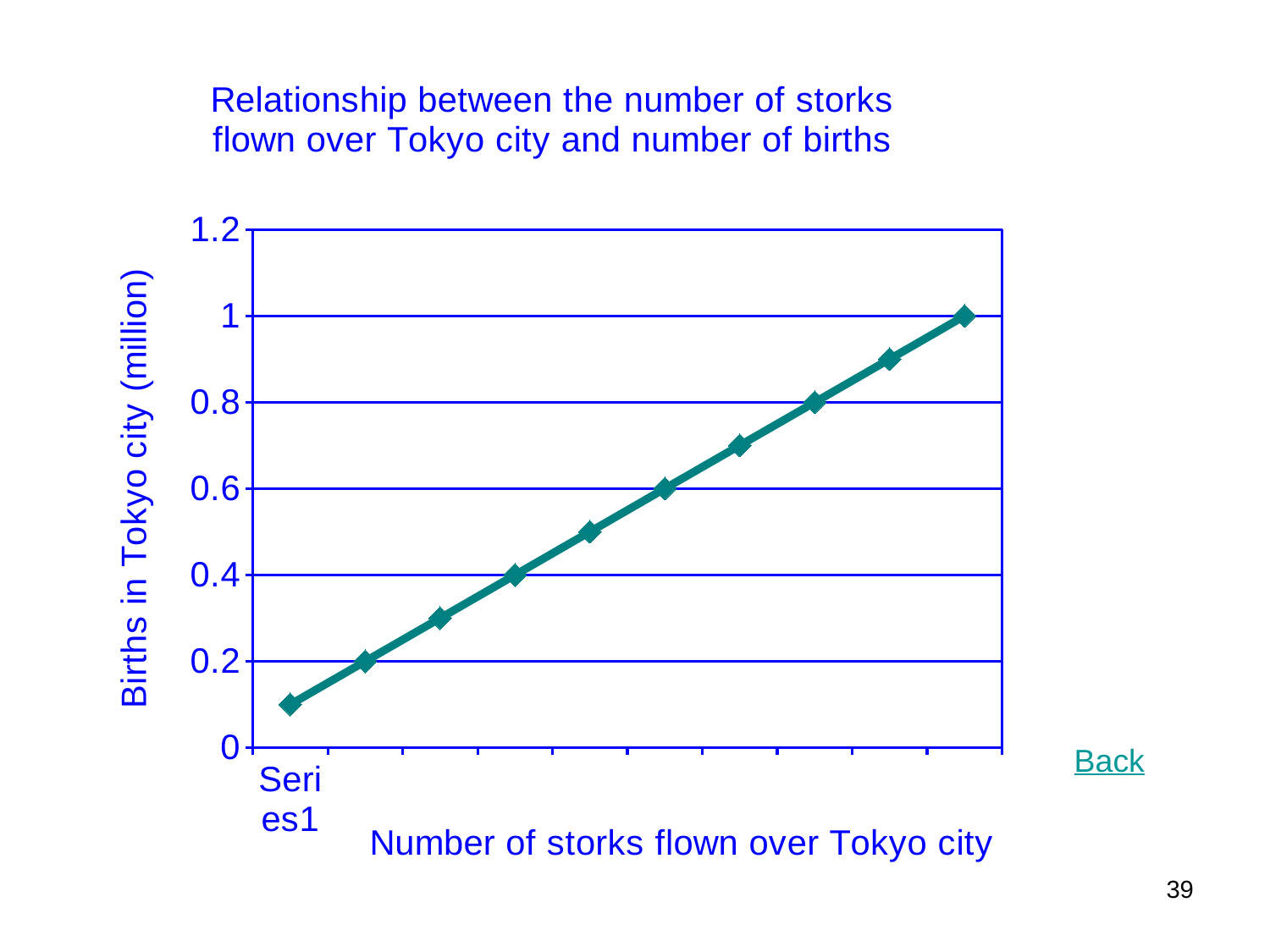
What kind of chart is shown on the slide? line chart What is the difference between the value of the last data point and the value of the second data point? 0.8 Which data point has the highest value, the leftmost or the rightmost? the rightmost What is the value of the sixth data point from the left? 0.6 Is the value of the ninth data point from the left greater or less than 0.8? greater What is the value of the second data point from the left? 0.2 What is the value of the rightmost (last) data point? 1 Is the value of the first (leftmost) data point greater or less than 0.2? less What is the title of the x axis? Number of storks flown over Tokyo city What is the title of the y axis? Births in Tokyo city (million) How many data points are plotted on the line? 10 Do the values rise or fall from left to right along the x axis? rise